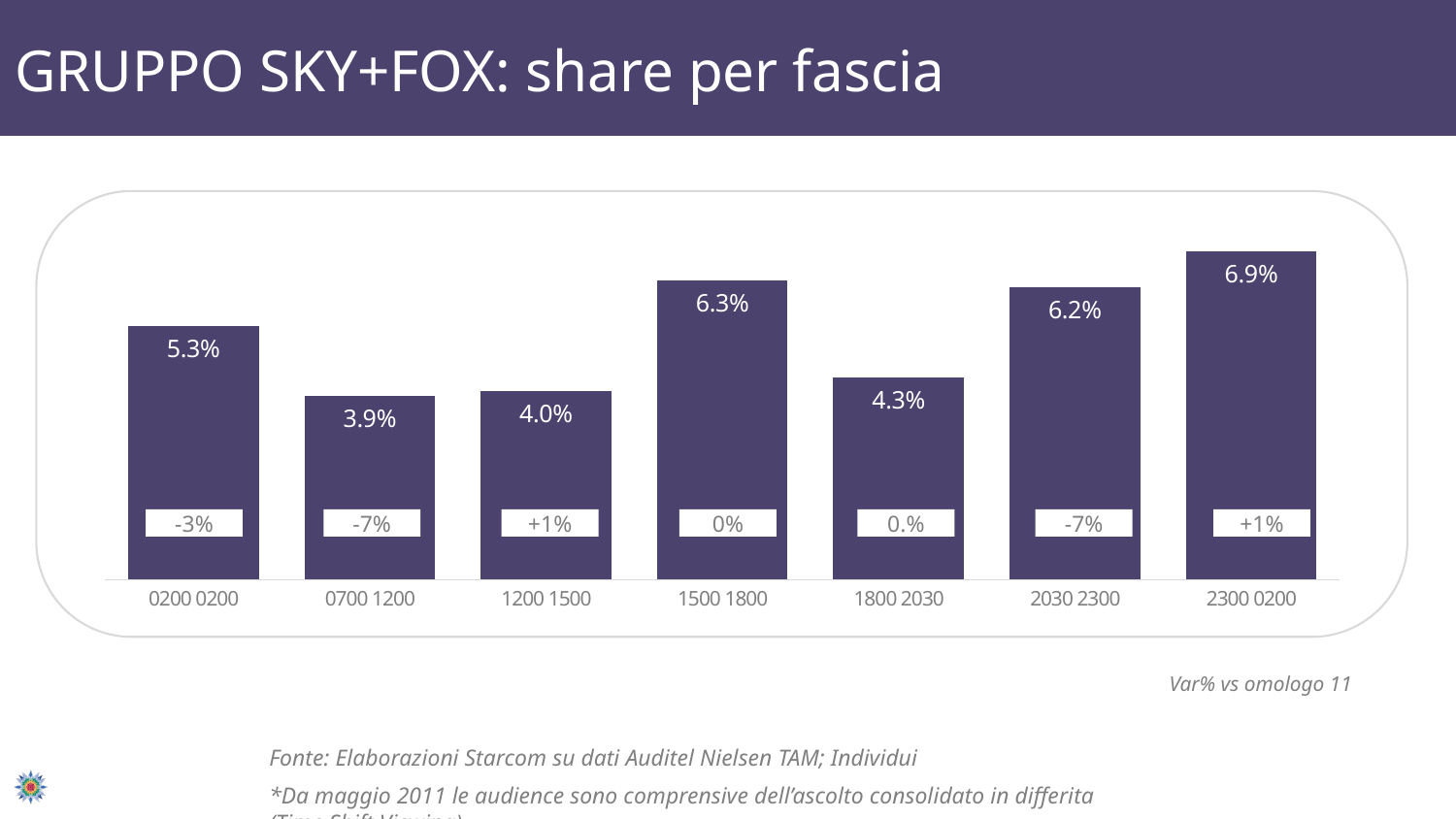
What is the share for the 1800 2030 time band? 4.3% What is the difference in share between the 2300 0200 and 0700 1200 time bands? 3.0% What kind of chart is shown on the slide? Bar chart Which time band has the lowest share? 0700 1200 Which time band has the highest share? 2300 0200 What is the share for the 1500 1800 time band? 6.3% What is the Var% vs omologo 11 shown for the 2300 0200 time band? +1% Which has a larger share, the 1500 1800 band or the 2030 2300 band? 1500 1800 What is the share for the 0200 0200 time band? 5.3% How many time bands are shown in the chart? 7 What is the Var% vs omologo 11 shown for the 0700 1200 time band? -7% What is the title of the slide? GRUPPO SKY+FOX: share per fascia